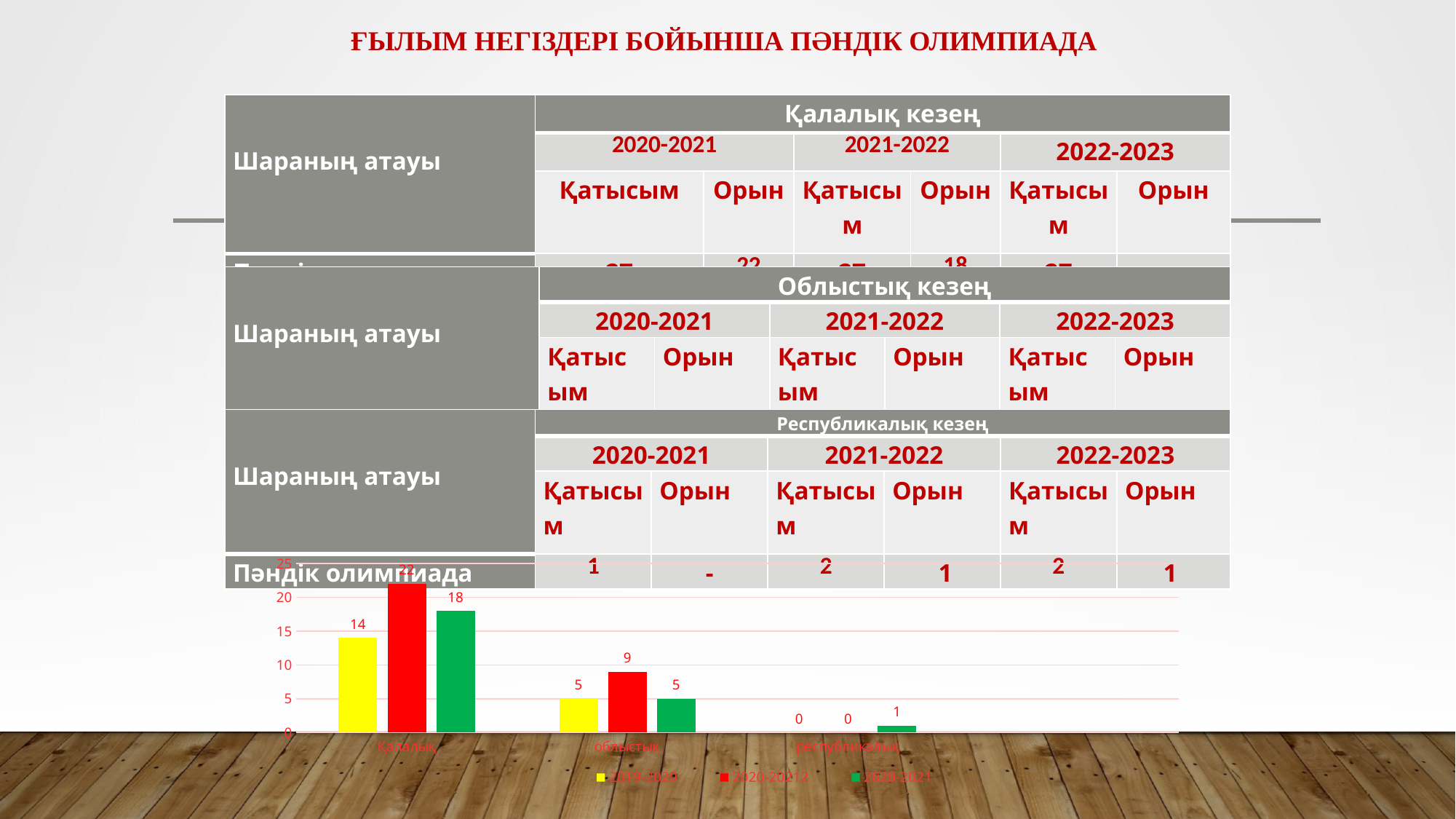
How many series does the legend of the bar chart list? 3 What is the difference between the red bar and the yellow bar for Қалалық? 8 Which category has the highest red bar? Қалалық What is the value of the yellow bar for Қалалық? 14 What kind of chart is shown at the bottom of the slide? bar chart Do the values of the green series rise or fall from Қалалық to республикалық? fall Is the yellow bar for облыстық larger or smaller than the red bar for облыстық? smaller What is the value of the green bar for республикалық? 1 Which category has the lowest green bar? республикалық How many categories are shown on the x axis of the bar chart? 3 What is the value of the red bar for облыстық? 9 What is the value of the green bar for Қалалық? 18